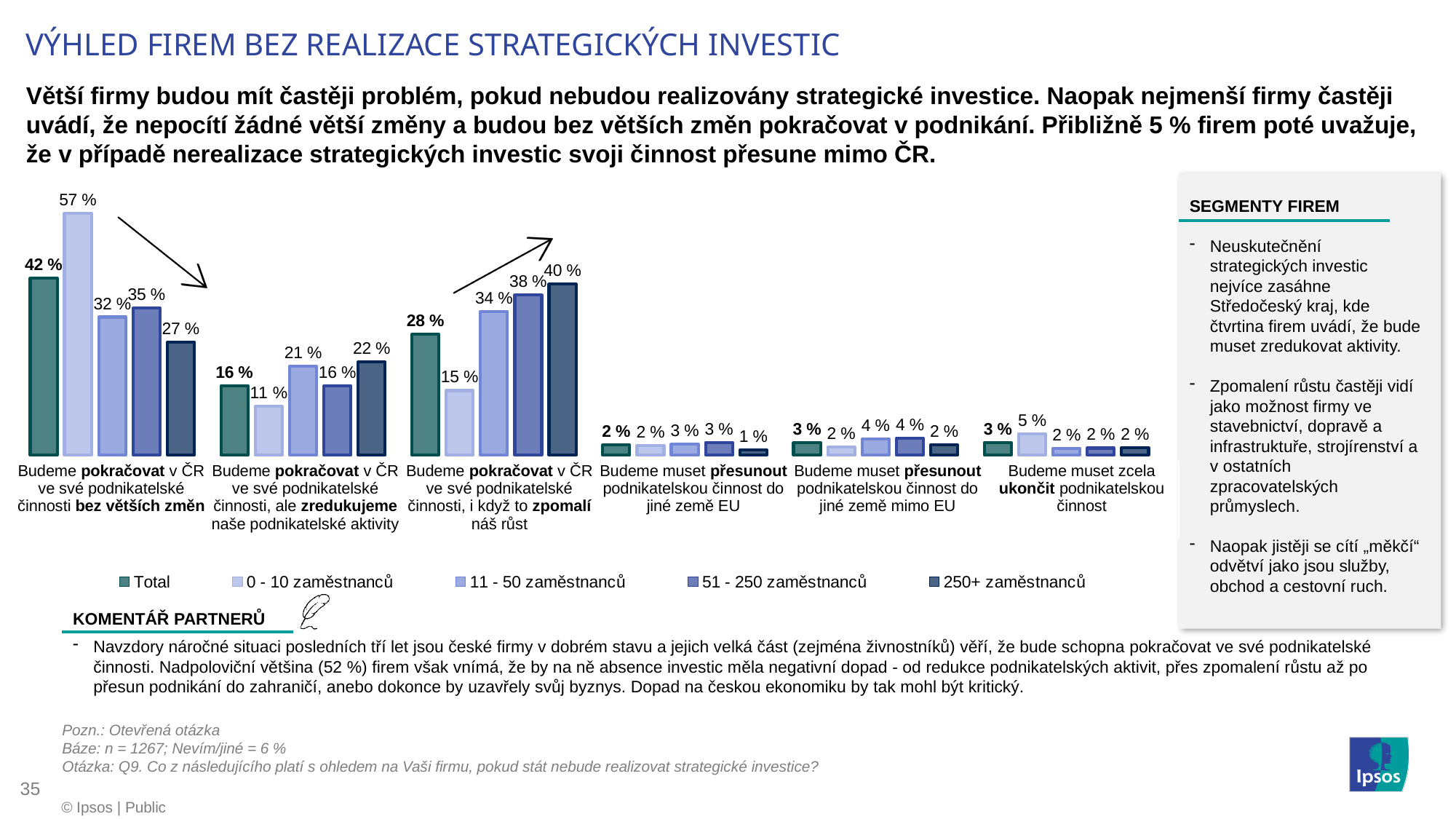
What is the difference between the '0 - 10 zaměstnanců' and '250+ zaměstnanců' values in the category 'Budeme pokračovat v ČR ve své podnikatelské činnosti bez větších změn'? 30 % What is the Total value for 'Budeme muset zcela ukončit podnikatelskou činnost'? 3 % How many series does the chart legend list? 5 What is the Total value for 'Budeme pokračovat v ČR ve své podnikatelské činnosti bez větších změn'? 42 % Which category has the highest Total value? Budeme pokračovat v ČR ve své podnikatelské činnosti bez větších změn In the category 'Budeme pokračovat v ČR ve své podnikatelské činnosti, ale zredukujeme naše podnikatelské aktivity', which is larger: the value for '11 - 50 zaměstnanců' or for '0 - 10 zaměstnanců'? 11 - 50 zaměstnanců What kind of chart is shown on the slide? bar chart Which employee-size series has the lowest value in the category 'Budeme pokračovat v ČR ve své podnikatelské činnosti, i když to zpomalí náš růst'? 0 - 10 zaměstnanců How many categories (response options) are shown on the x axis of the chart? 6 Which series in the legend is shown in the darkest colour? 250+ zaměstnanců What is the value for '0 - 10 zaměstnanců' in the category 'Budeme pokračovat v ČR ve své podnikatelské činnosti bez větších změn'? 57 % What is the value for '250+ zaměstnanců' in the category 'Budeme pokračovat v ČR ve své podnikatelské činnosti, i když to zpomalí náš růst'? 40 %